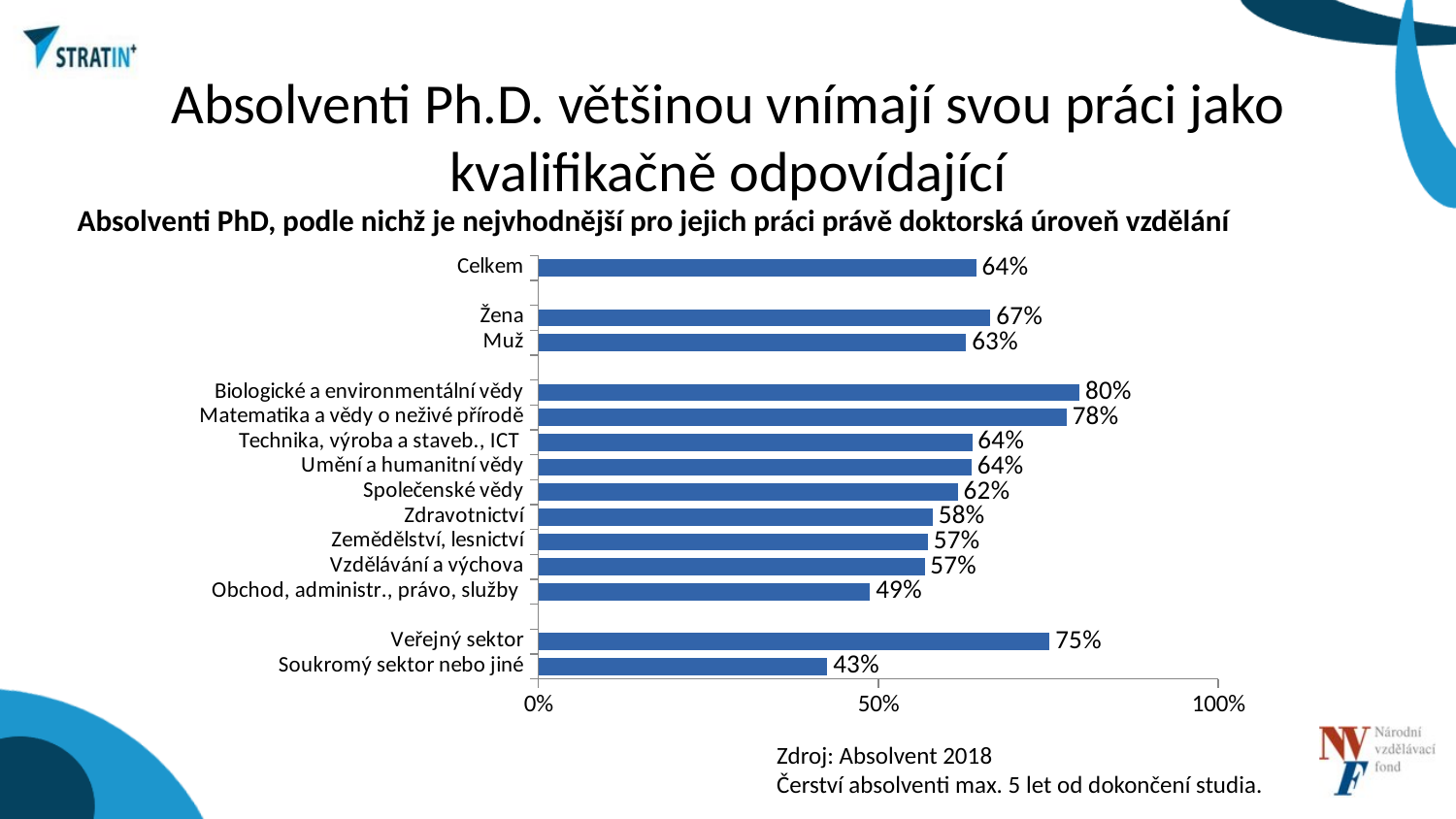
How many bars are shown in the chart? 14 What kind of chart is shown on the slide? bar chart What is the difference between the values for Veřejný sektor and Soukromý sektor nebo jiné? 32% What is the value for Celkem? 64% Which is larger, the value for Matematika a vědy o neživé přírodě or the value for Zdravotnictví? Matematika a vědy o neživé přírodě What is the value for Biologické a environmentální vědy? 80% What is the value for Obchod, administr., právo, služby? 49% Which category has the highest value? Biologické a environmentální vědy What is the difference between the values for Žena and Muž? 4% What is the value for Soukromý sektor nebo jiné? 43% Which category has the lowest value? Soukromý sektor nebo jiné Is the value for Obchod, administr., právo, služby greater or less than 50%? less